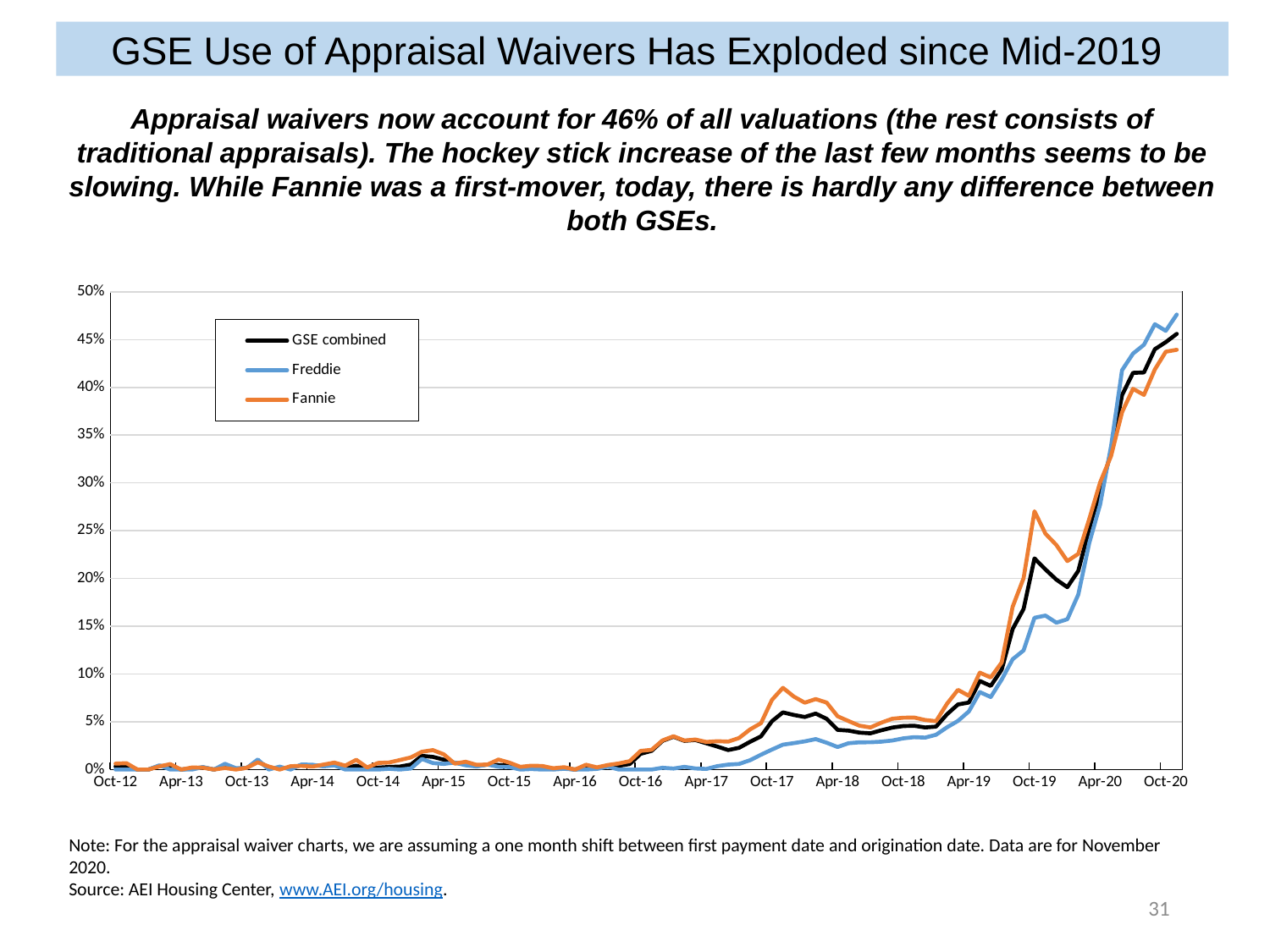
Which series has the highest value at Oct-20? Freddie What kind of chart is shown on the slide? line chart Is the value for Freddie at Oct-19 greater or less than 20%? less Do the values for GSE combined rise or fall between Apr-19 and Oct-20? rise Which series are listed in the chart legend? GSE combined, Freddie, Fannie Is the value for GSE combined at Oct-20 greater or less than 40%? greater How many series does the legend list? 3 How many date labels are shown along the horizontal axis? 17 At Oct-19, which is larger, the value for Fannie or the value for Freddie? Fannie What is the highest value shown on the vertical axis? 50% Which series has the lowest value at Oct-19? Freddie Is the value for Freddie at Apr-18 greater or less than 5%? less